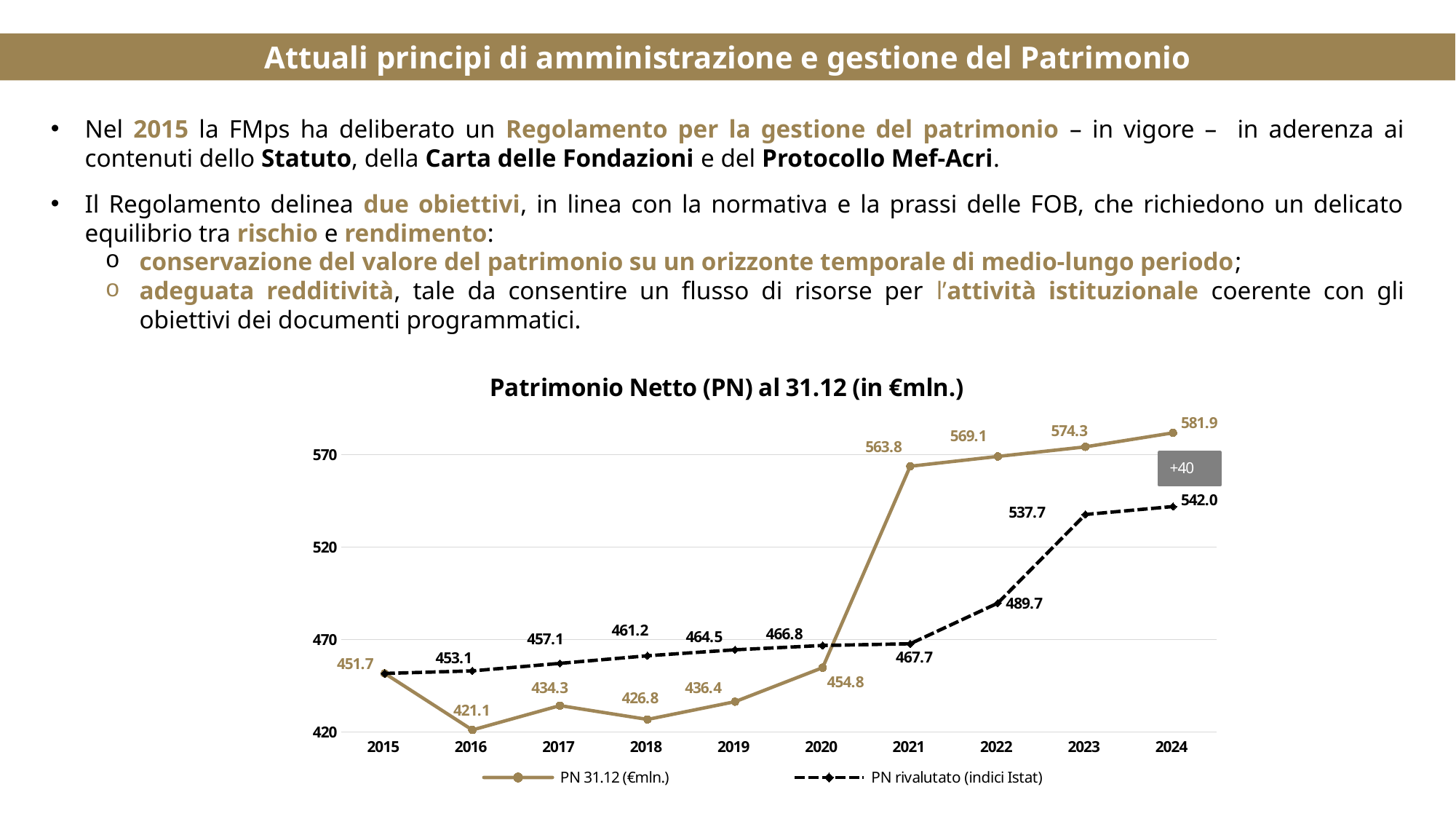
How many series does the legend of the chart list? 2 In 2019, which series has the larger value: PN 31.12 (€mln.) or PN rivalutato (indici Istat)? PN rivalutato (indici Istat) What is the value of the PN rivalutato (indici Istat) series in 2023? 537.7 What is the value of the PN 31.12 (€mln.) series in 2024? 581.9 What is the difference between the PN 31.12 (€mln.) value and the PN rivalutato (indici Istat) value in 2024? 39.9 What kind of chart is shown under the title "Patrimonio Netto (PN) al 31.12 (in €mln.)"? Line chart In which year is the PN 31.12 (€mln.) series at its lowest? 2016 Does the PN rivalutato (indici Istat) series rise or fall from 2015 to 2024? Rise What is the difference between the PN 31.12 (€mln.) values in 2021 and 2020? 109.0 How many years are plotted along the x axis of the chart? 10 What is the value of the PN 31.12 (€mln.) series in 2016? 421.1 In which year is the PN rivalutato (indici Istat) series at its highest? 2024